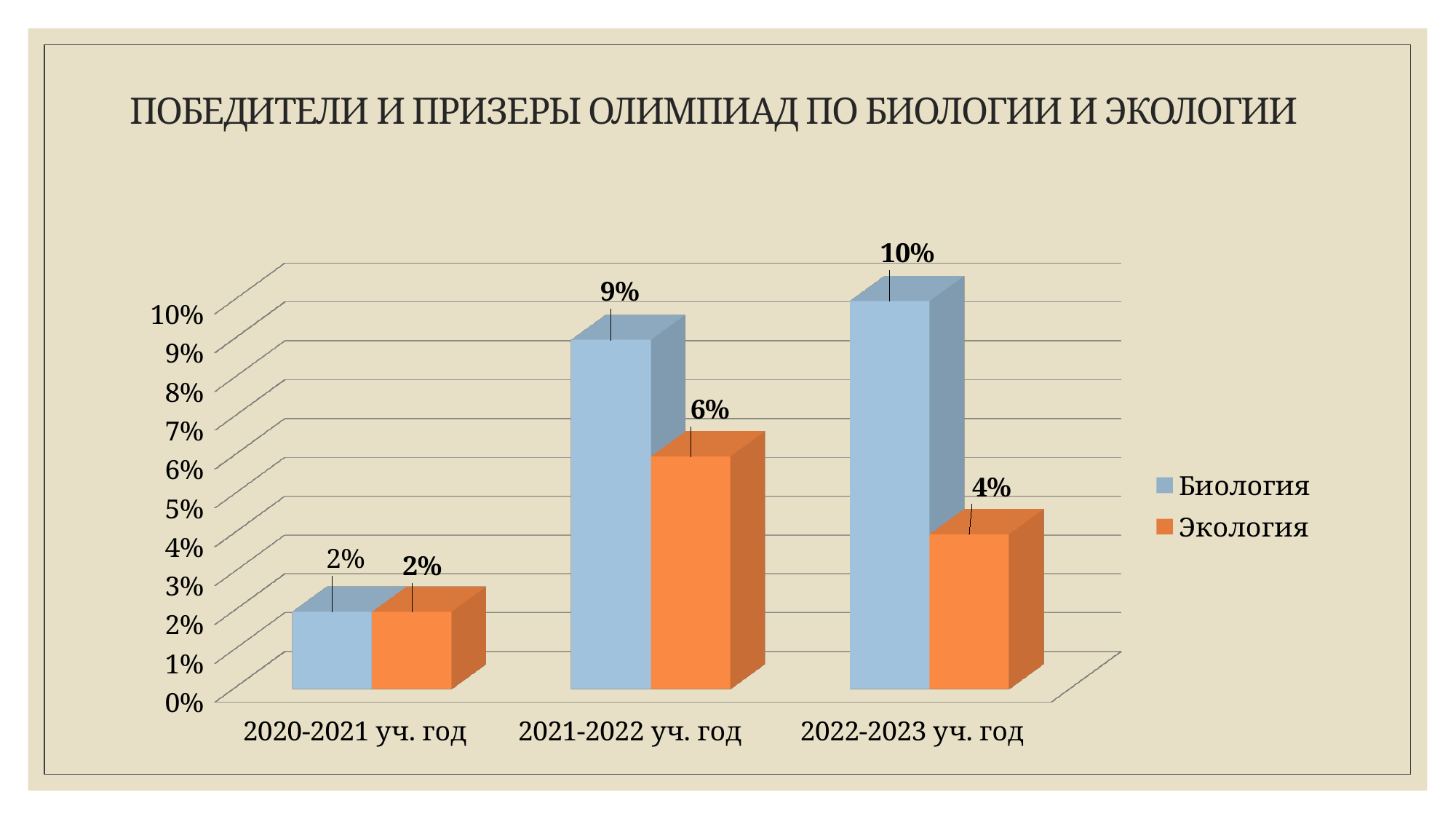
What is the value for Экология in 2022-2023 уч. год? 4% How many series does the legend list? 2 What is the difference between the Биология values for 2021-2022 уч. год and 2020-2021 уч. год? 7% What kind of chart is shown on the slide? Bar chart What is the difference between the Биология and Экология values in 2022-2023 уч. год? 6% In which academic year is the Экология value lowest? 2020-2021 уч. год In which academic year is the Биология value highest? 2022-2023 уч. год How many academic years are shown on the x axis? 3 What is the value for Биология in 2021-2022 уч. год? 9% Does the Биология value rise or fall from 2020-2021 уч. год to 2022-2023 уч. год? Rise What is the value for Экология in 2020-2021 уч. год? 2% Which is larger in 2021-2022 уч. год, Биология or Экология? Биология